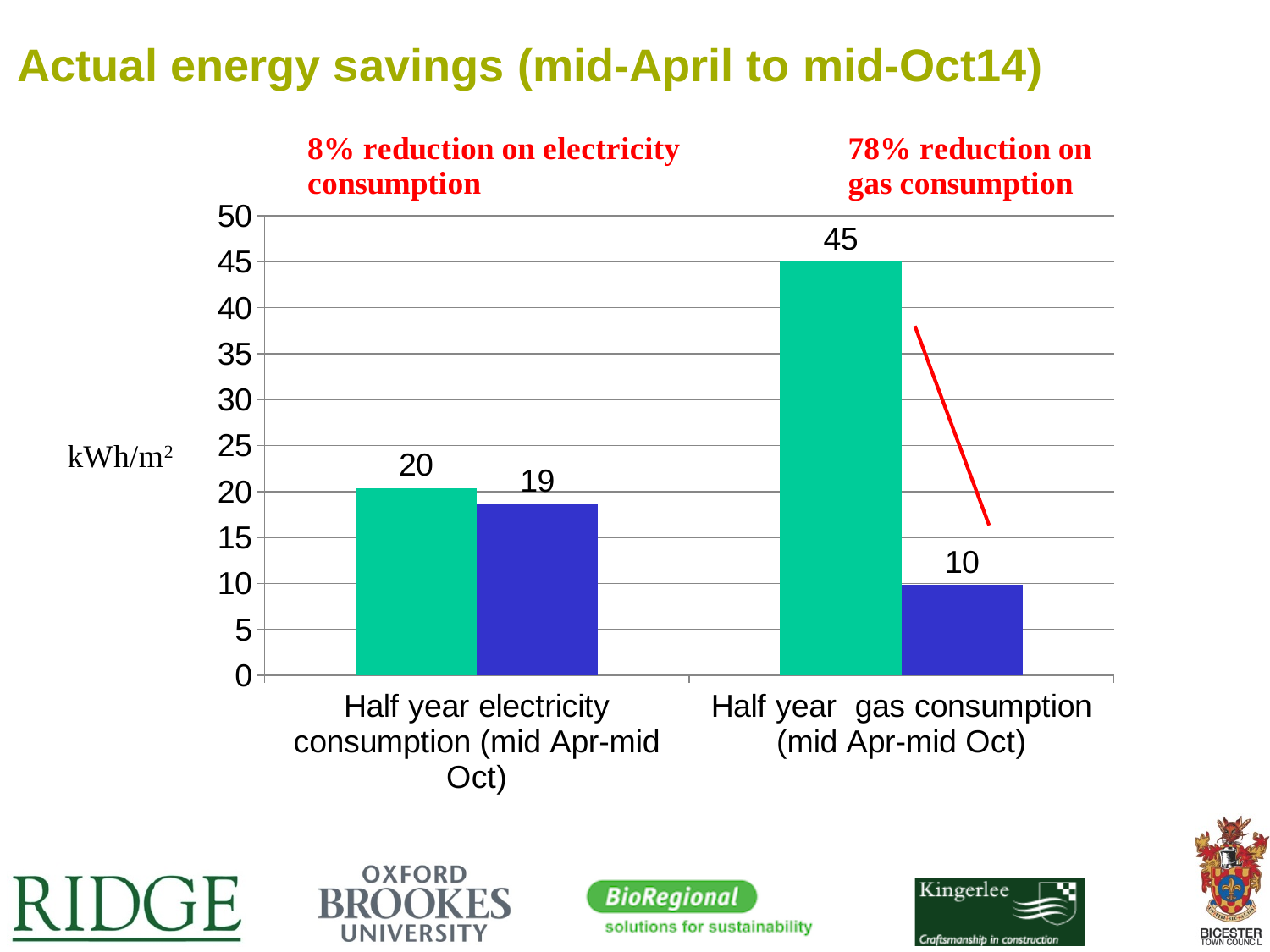
What type of chart is shown on the slide? Bar chart Which is larger: the green bar for gas consumption or the green bar for electricity consumption? The green bar for gas consumption What is the value of the green bar for Half year electricity consumption (mid Apr-mid Oct)? 20 What is the value of the green bar for Half year gas consumption (mid Apr-mid Oct)? 45 What is the difference between the green and blue bars for Half year gas consumption (mid Apr-mid Oct)? 35 Which bar on the chart has the highest value? The green bar for Half year gas consumption (mid Apr-mid Oct) What is the value of the blue bar for Half year gas consumption (mid Apr-mid Oct)? 10 How many categories are shown on the x axis of the chart? 2 What is the difference between the green and blue bars for Half year electricity consumption (mid Apr-mid Oct)? 1 What unit is shown on the y axis of the chart? kWh/m² What is the value of the blue bar for Half year electricity consumption (mid Apr-mid Oct)? 19 Which bar on the chart has the lowest value? The blue bar for Half year gas consumption (mid Apr-mid Oct)